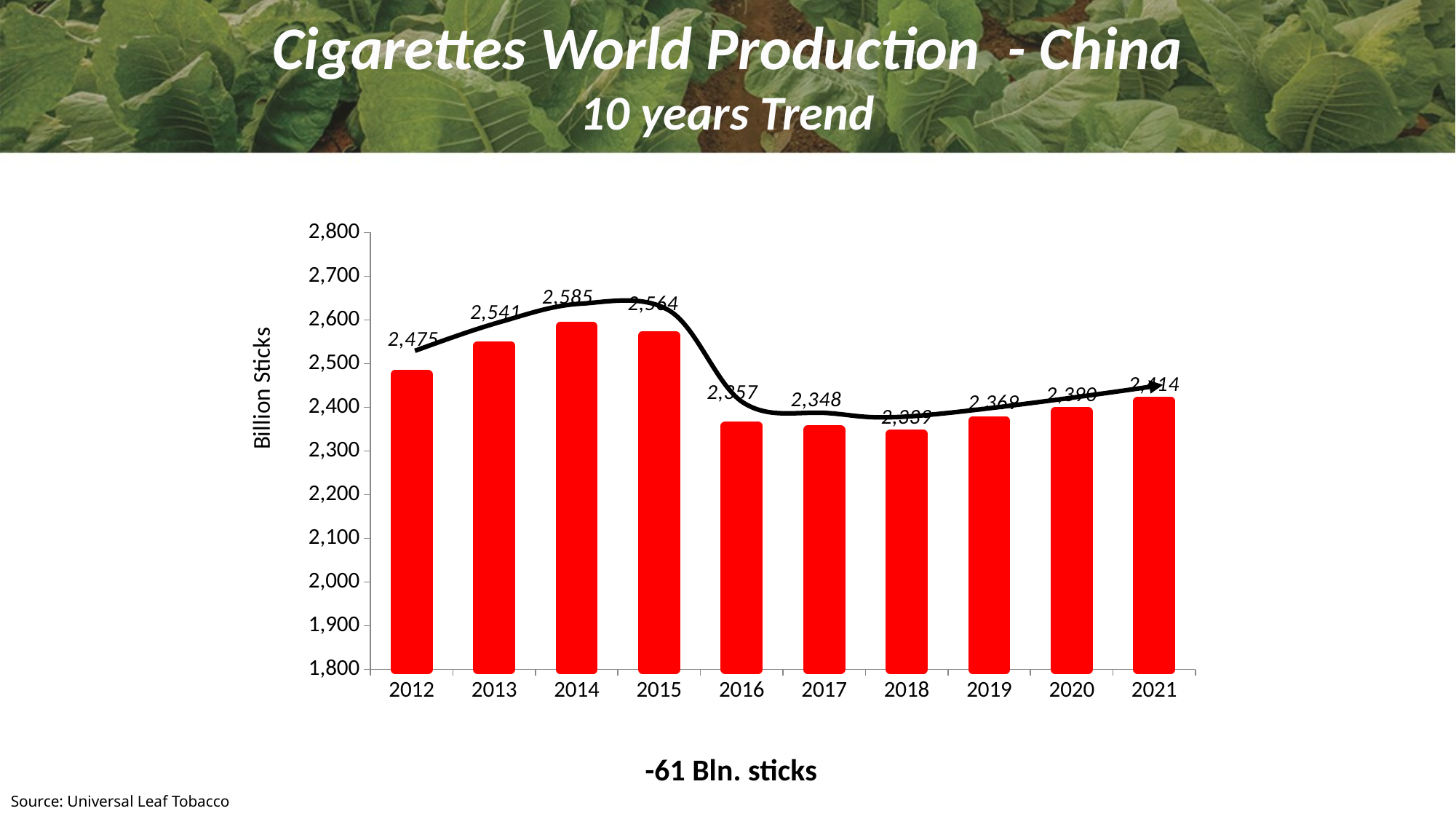
What value is shown for 2014? 2,585 How many years are shown on the x axis? 10 Is the value for 2016 greater or less than 2,400? less What was China's cigarette production in 2012? 2,475 What kind of chart is this? bar chart What value is shown for 2013? 2,541 Which year has the highest production? 2014 What value is shown for 2017? 2,348 What is the difference between the 2014 and 2013 values? 44 Is the value for 2015 greater or less than 2,500? greater Which is larger, the value for 2013 or the value for 2017? 2013 What is the label on the vertical axis? Billion Sticks